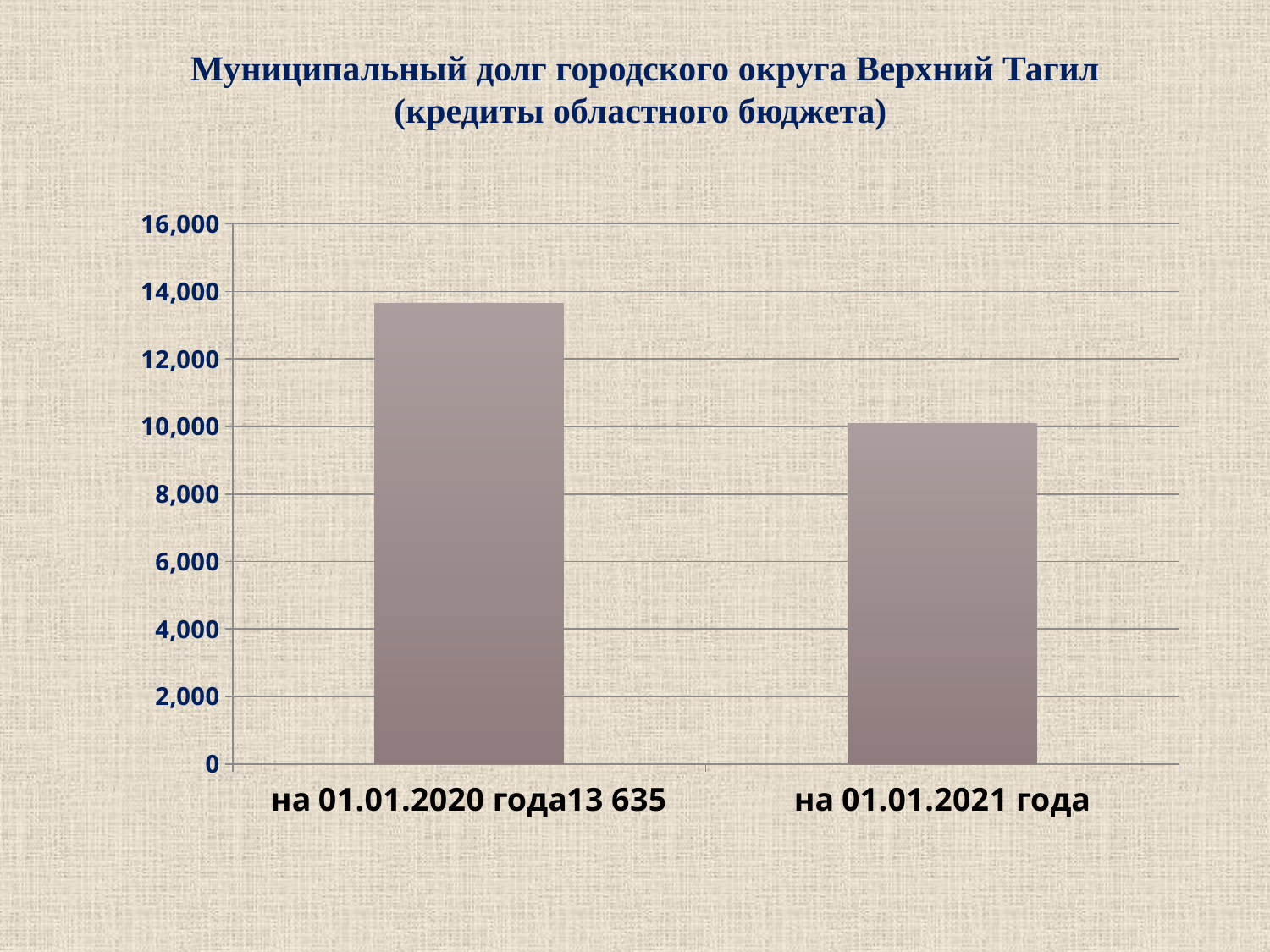
Is the value for на 01.01.2020 года greater or less than 12,000? greater Which is larger: the value for на 01.01.2020 года or the value for на 01.01.2021 года? на 01.01.2020 года Is the value for на 01.01.2021 года greater or less than 8,000? greater What is the highest tick value shown on the vertical axis? 16,000 What value is printed next to the category label for 01.01.2020? 13 635 What kind of chart is shown on the slide? bar chart Which category has the highest value? на 01.01.2020 года What is the title of the chart? Муниципальный долг городского округа Верхний Тагил (кредиты областного бюджета) Is the value for на 01.01.2021 года greater or less than 12,000? less How many bars are plotted in the chart? 2 Which category has the lowest value? на 01.01.2021 года Do the values rise or fall from 01.01.2020 to 01.01.2021? fall